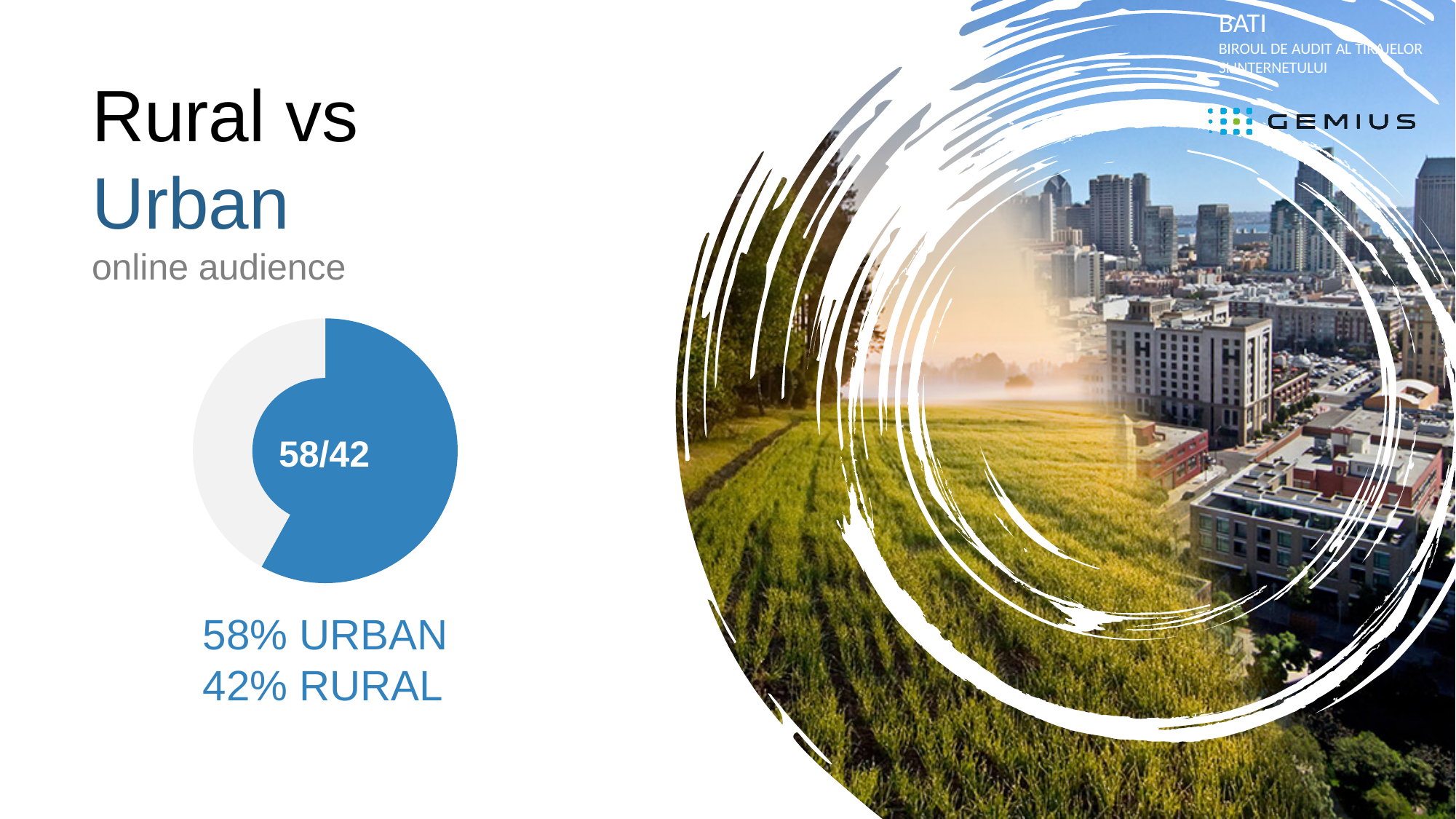
What share of the online audience is urban according to the chart? 58% What kind of chart is shown on the slide? Doughnut chart Is the urban share greater or less than 50%? greater Which segment is larger, urban or rural? Urban How many segments does the chart have? 2 What is the total of the urban and rural shares? 100% Which segment has the smallest share in the chart? Rural What label is printed in the centre of the chart? 58/42 What share of the online audience is rural according to the chart? 42% Which segment has the largest share in the chart? Urban What colour is the urban segment of the chart? Blue What is the difference in percentage points between the urban and rural shares? 16